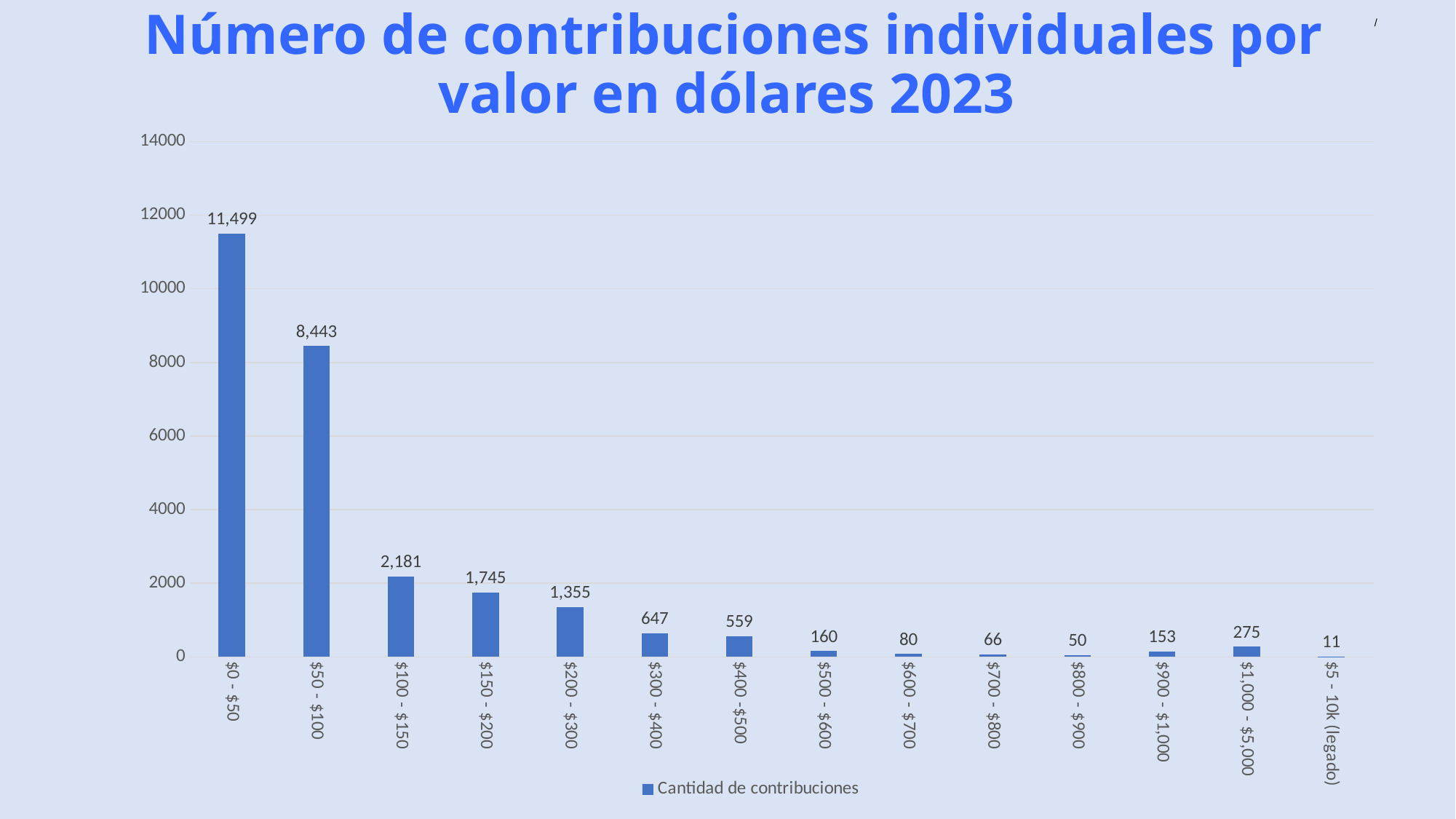
What kind of chart is shown on the slide? Bar chart How many categories are shown on the x axis? 14 What is the legend entry for the series? Cantidad de contribuciones Which has more contributions, $900 - $1,000 or $500 - $600? $900 - $1,000 What is the difference between the contributions for $0 - $50 and $50 - $100? 3,056 Is the value for $100 - $150 greater or less than 2000? greater Which category has the highest number of contributions? $0 - $50 What is the number of contributions for the $1,000 - $5,000 range? 275 What is the number of contributions for the $200 - $300 range? 1,355 What is the number of contributions for the $0 - $50 range? 11,499 Which category has the lowest number of contributions? $5 - 10k (legado) How many series does the legend list? 1